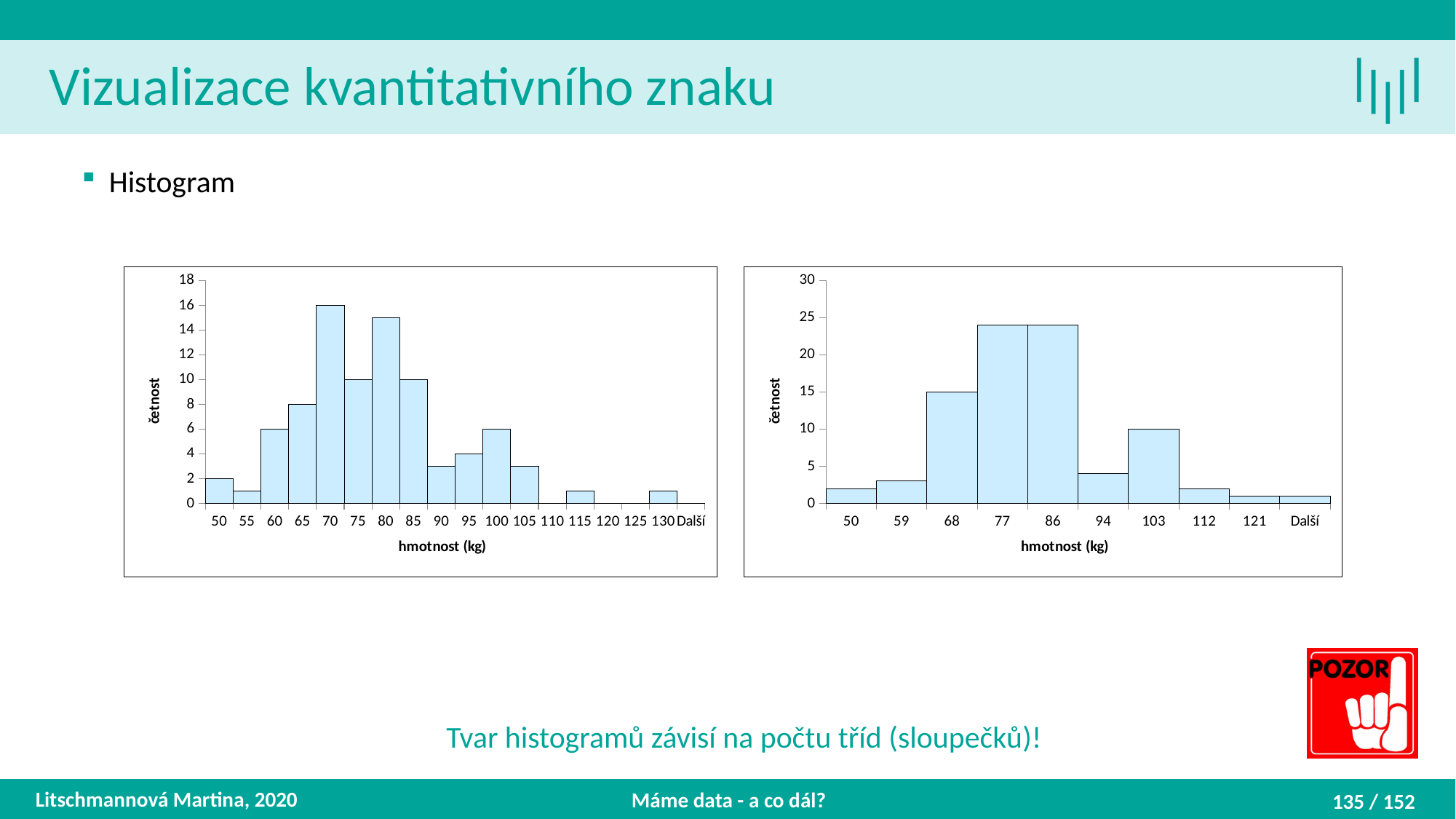
What type of chart is shown on the left? Bar chart (histogram) In the left chart, is the frequency for the 80 kg class greater or less than 14? greater In the right chart, what is the frequency for the 103 kg class? 10 In the left chart, which class has a higher frequency, 70 or 80? 70 In the right chart, is the frequency for the 94 kg class greater or less than 5? less In the right chart, how many classes (bars) are shown on the x axis, including 'Další'? 10 In the right chart, what is the frequency for the 68 kg class? 15 In the left chart, what is the frequency for the 75 kg class? 10 In the right chart, is the frequency for the 77 kg class greater or less than 20? greater In the left chart, which class has the highest frequency? 70 What is the label of the x axis in both charts? hmotnost (kg) In the left chart, what is the frequency (četnost) for the 70 kg class? 16